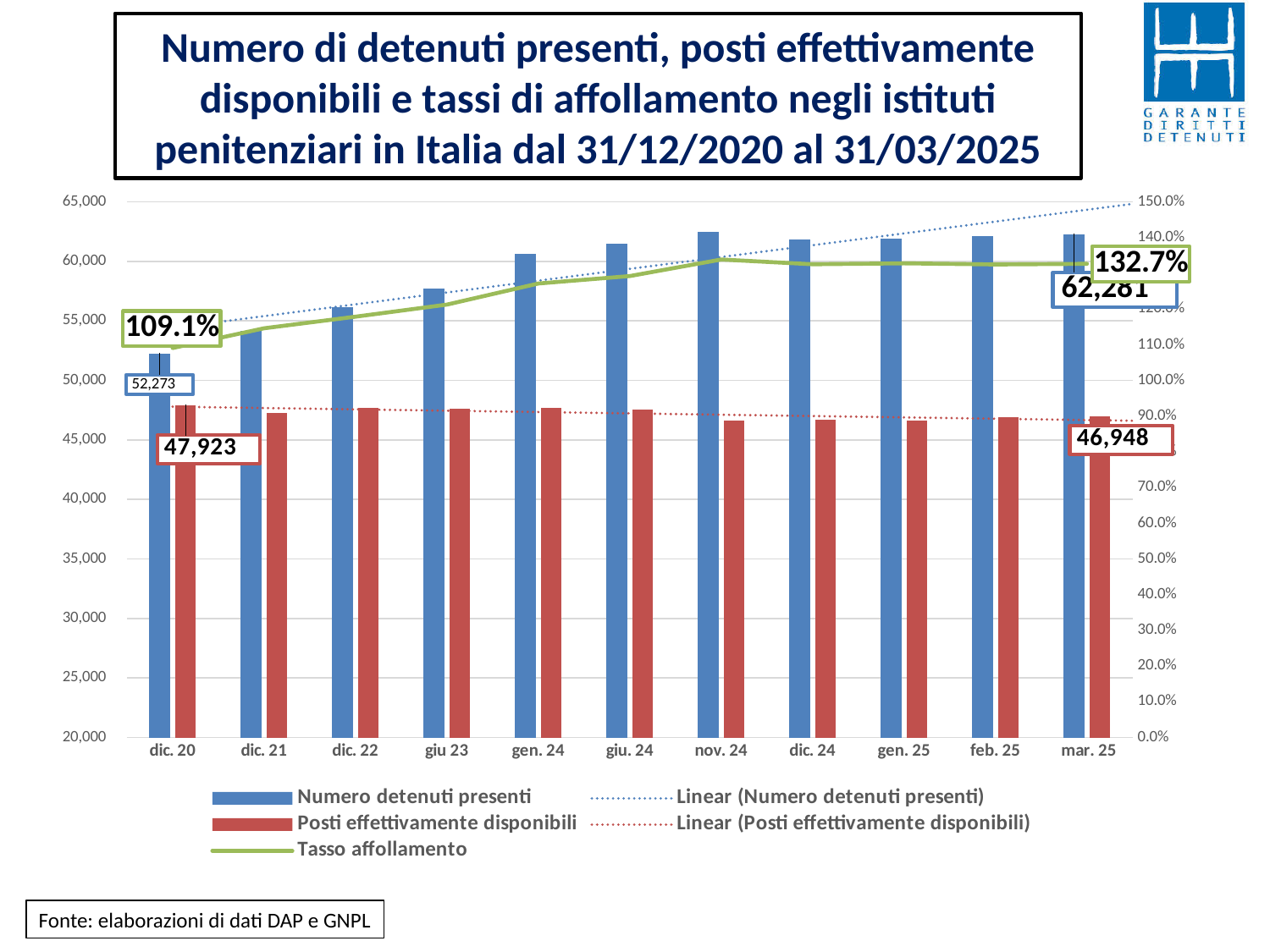
How many entries does the legend list? 5 What is the Tasso affollamento for dic. 20? 109.1% What is the Tasso affollamento for mar. 25? 132.7% What is the value of Posti effettivamente disponibili for mar. 25? 46,948 By how many percentage points did the Tasso affollamento change from dic. 20 to mar. 25? 23.6 percentage points What is the value of Posti effettivamente disponibili for dic. 20? 47,923 What is the difference between Numero detenuti presenti and Posti effettivamente disponibili for dic. 20? 4,350 What is the value of Numero detenuti presenti for dic. 20? 52,273 Does the Numero detenuti presenti generally rise or fall from dic. 20 to mar. 25? Rise What kind of chart is this? Bar chart with a line Is the value of Numero detenuti presenti for nov. 24 greater or less than 60,000? greater How many time periods are shown on the x axis? 11